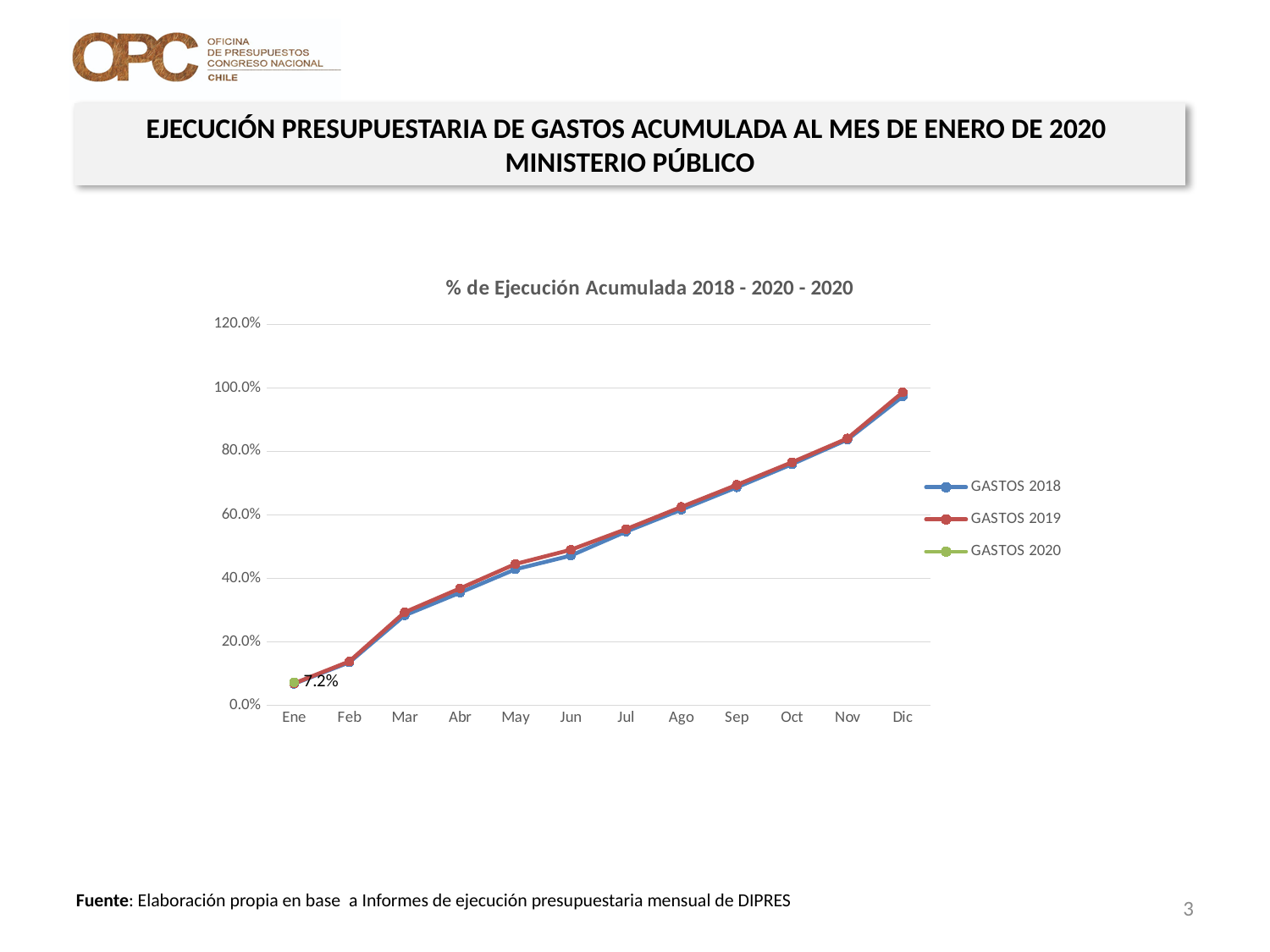
In which month is the value for GASTOS 2019 lowest? Ene Do the values for GASTOS 2019 rise or fall from Ene to Dic? Rise In which month is the value for GASTOS 2019 highest? Dic How many series does the legend list? 3 What is the title of the chart? % de Ejecución Acumulada 2018 - 2020 - 2020 Is the value for GASTOS 2018 in Jun greater or less than 60.0%? less Is the value for GASTOS 2019 in Dic greater or less than 80.0%? greater Is the value for GASTOS 2019 in Feb greater or less than 20.0%? less What is the value for GASTOS 2020 in Ene? 7.2% How many months are shown on the x axis? 12 What kind of chart is shown on the slide? Line chart